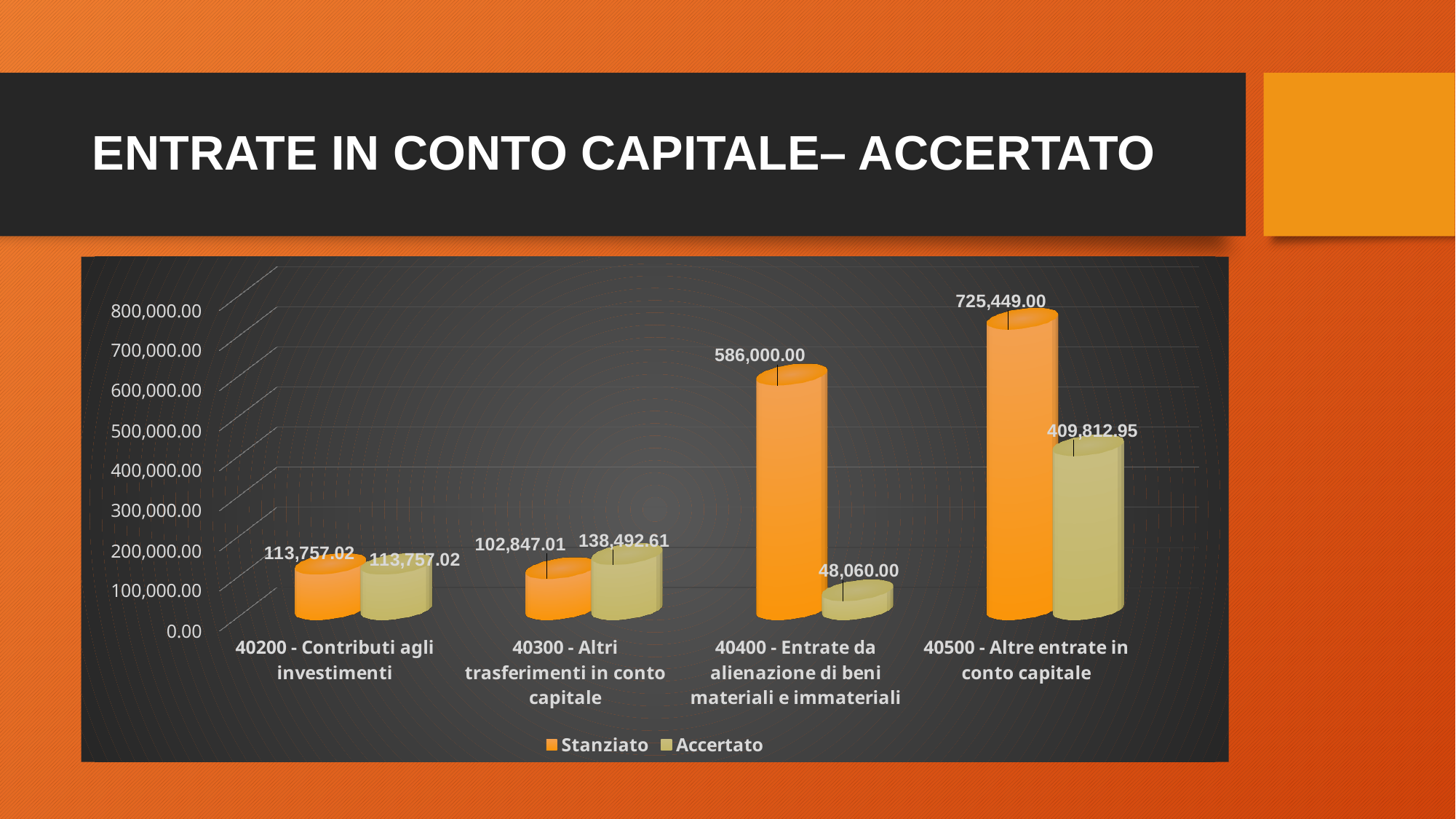
What is the Stanziato value for 40500 - Altre entrate in conto capitale? 725,449.00 Which category has the lowest Accertato value? 40400 - Entrate da alienazione di beni materiali e immateriali How many categories are shown on the x axis? 4 What is the Accertato value for 40300 - Altri trasferimenti in conto capitale? 138,492.61 What is the difference between the Stanziato and Accertato values for 40400 - Entrate da alienazione di beni materiali e immateriali? 537,940.00 What kind of chart is shown on the slide? Bar chart What is the Accertato value for 40400 - Entrate da alienazione di beni materiali e immateriali? 48,060.00 What is the difference between the Stanziato and Accertato values for 40500 - Altre entrate in conto capitale? 315,636.05 How many series does the legend list? 2 For 40300 - Altri trasferimenti in conto capitale, which is larger: Stanziato or Accertato? Accertato Which category has the highest Stanziato value? 40500 - Altre entrate in conto capitale What is the Stanziato value for 40200 - Contributi agli investimenti? 113,757.02